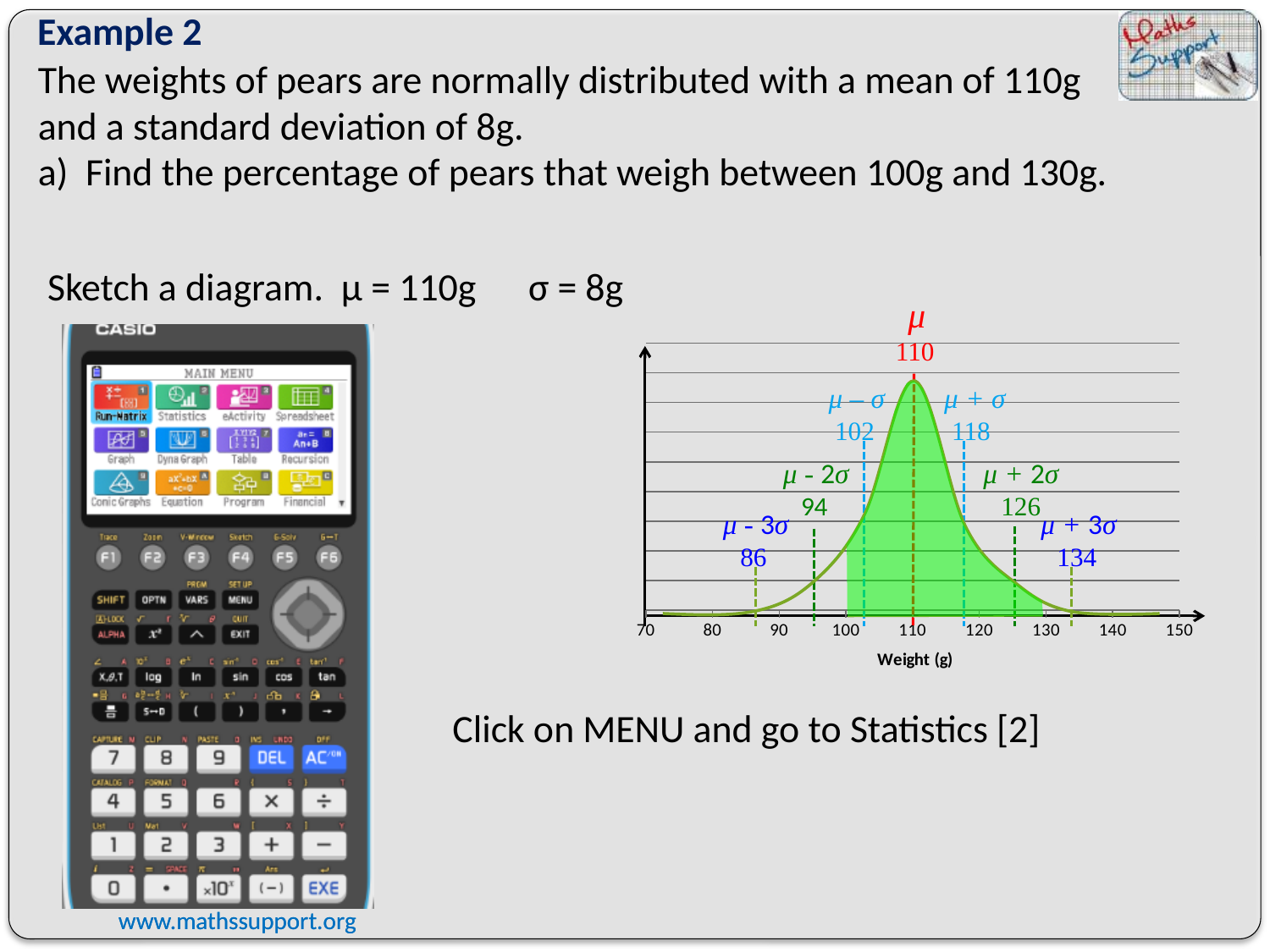
What is the label of the horizontal axis of the chart? Weight (g) Does the curve rise or fall as the weight increases from 110 to 150? fall On the chart, what is the difference between the values marked at μ + σ and μ − σ? 16 How many tick labels are shown on the horizontal axis of the chart? 9 On the chart, what weight value is marked at μ − 3σ? 86 On the chart, what weight value is marked at μ − σ? 102 On the chart, what weight value is marked at μ + 2σ? 126 On the chart, what weight value is marked at μ + σ? 118 On the chart, what weight value is marked at the mean μ? 110 On the chart, what weight value is marked at μ + 3σ? 134 On the chart, what is the difference between the values marked at μ + 3σ and μ − 2σ? 40 Between which two weight values is the region under the curve shaded green? 100 and 130